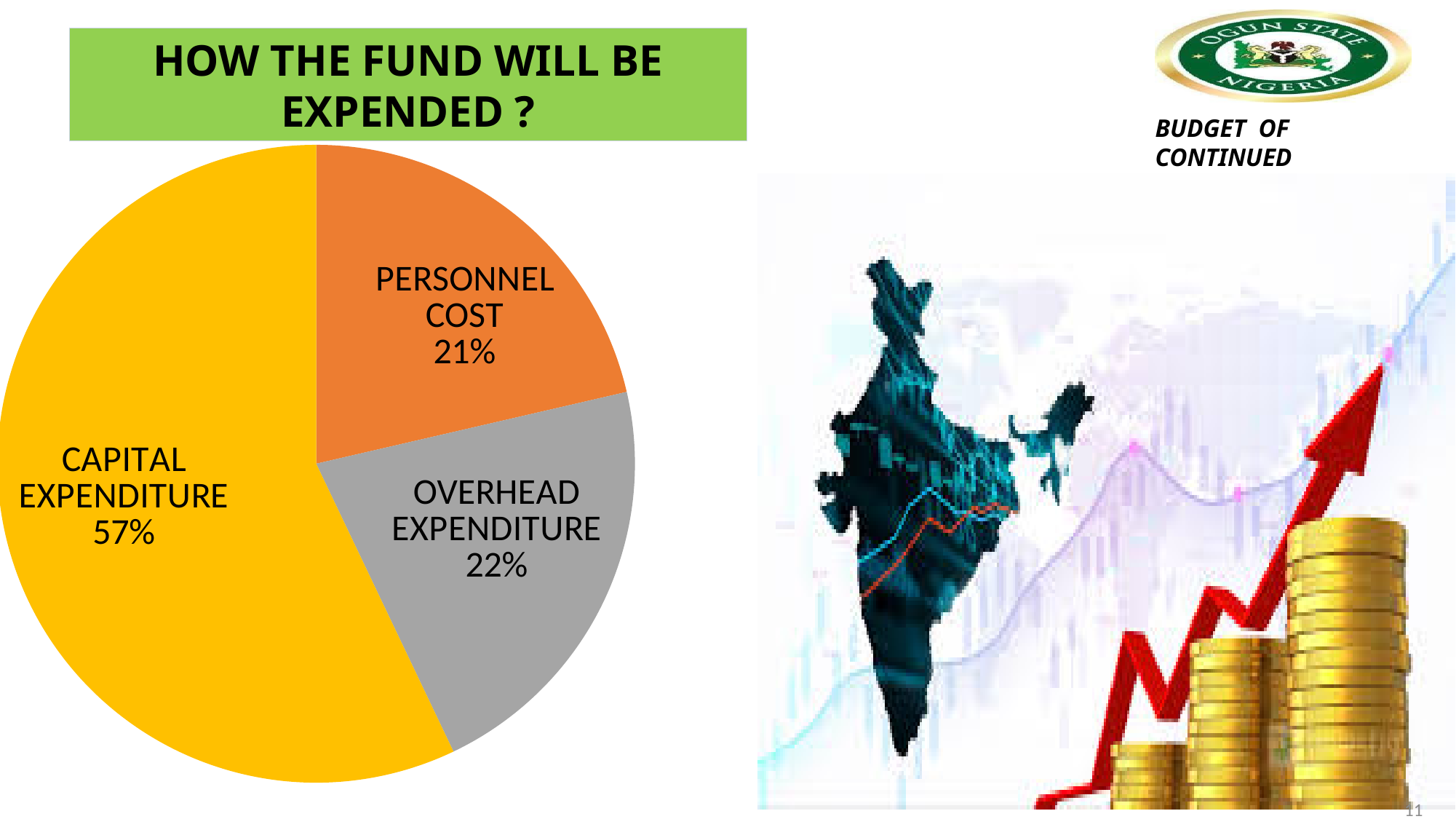
Which category receives the smallest share of the fund? Personnel Cost What share of the fund goes to Capital Expenditure? 57% What colour is the Capital Expenditure slice? Yellow What share of the fund goes to Overhead Expenditure? 22% Which category receives the largest share of the fund? Capital Expenditure What kind of chart is shown on the slide? Pie chart What is the difference in percentage points between Overhead Expenditure and Personnel Cost? 1 What share of the fund goes to Personnel Cost? 21% Which is larger, the share for Capital Expenditure or the share for Personnel Cost? Capital Expenditure How many categories are shown in the pie chart? 3 What is the difference in percentage points between Capital Expenditure and Overhead Expenditure? 35 What is the title of the chart? HOW THE FUND WILL BE EXPENDED ?